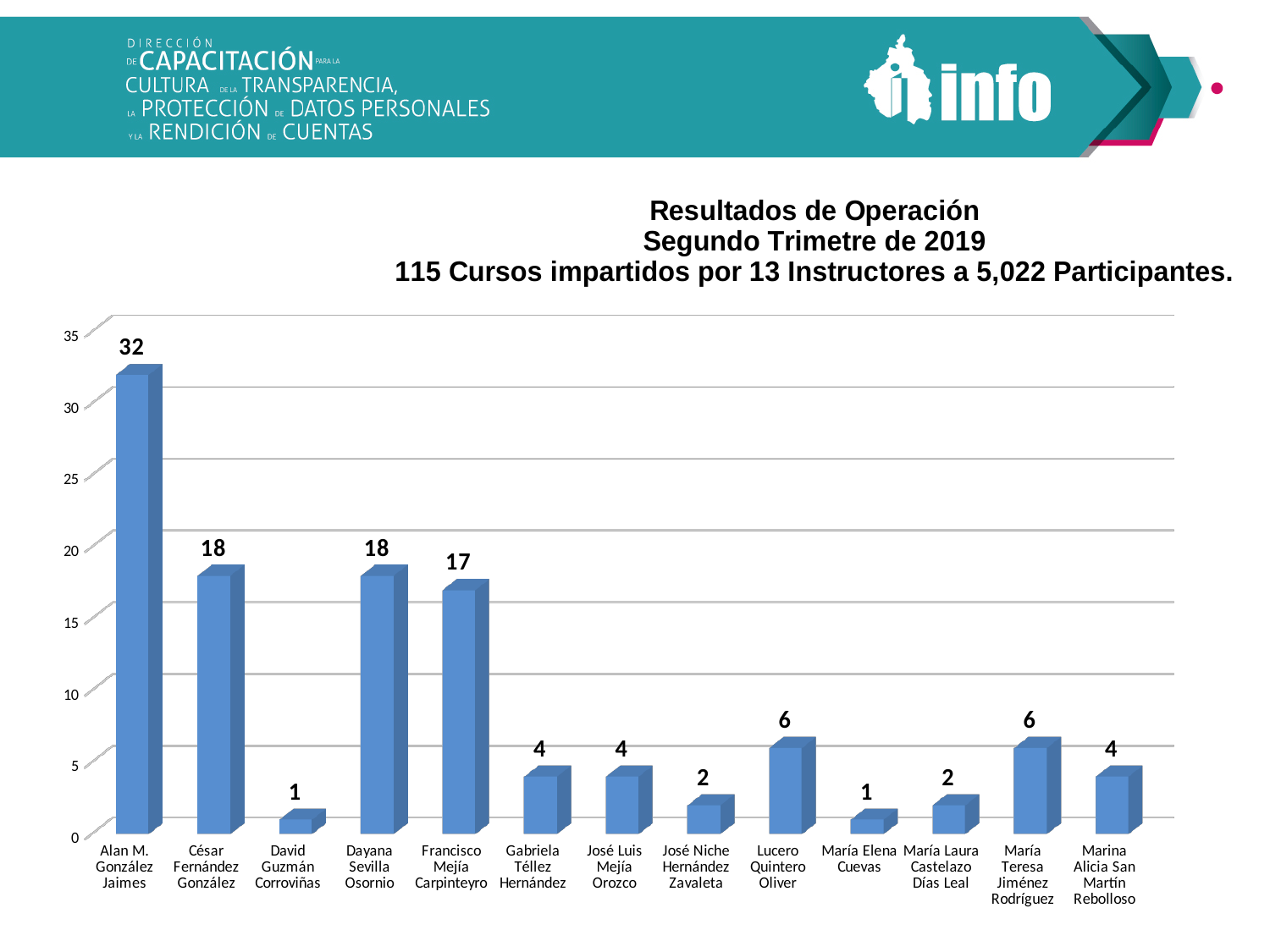
Which instructor has the highest value in the chart? Alan M. González Jaimes What is the title of the chart on the slide? Resultados de Operación Segundo Trimetre de 2019 115 Cursos impartidos por 13 Instructores a 5,022 Participantes. Which is larger, the value for Dayana Sevilla Osornio or the value for Francisco Mejía Carpinteyro? Dayana Sevilla Osornio How many instructors (categories) are shown on the x axis of the chart? 13 What is the value shown for Francisco Mejía Carpinteyro? 17 What is the difference between the values for María Teresa Jiménez Rodríguez and María Laura Castelazo Días Leal? 4 What is the value shown for José Niche Hernández Zavaleta? 2 How many courses did Alan M. González Jaimes teach according to the chart? 32 Is the value for Alan M. González Jaimes greater or less than 30? greater What kind of chart is shown on the slide? bar chart What is the value shown for Lucero Quintero Oliver? 6 What is the difference between the values for Alan M. González Jaimes and César Fernández González? 14